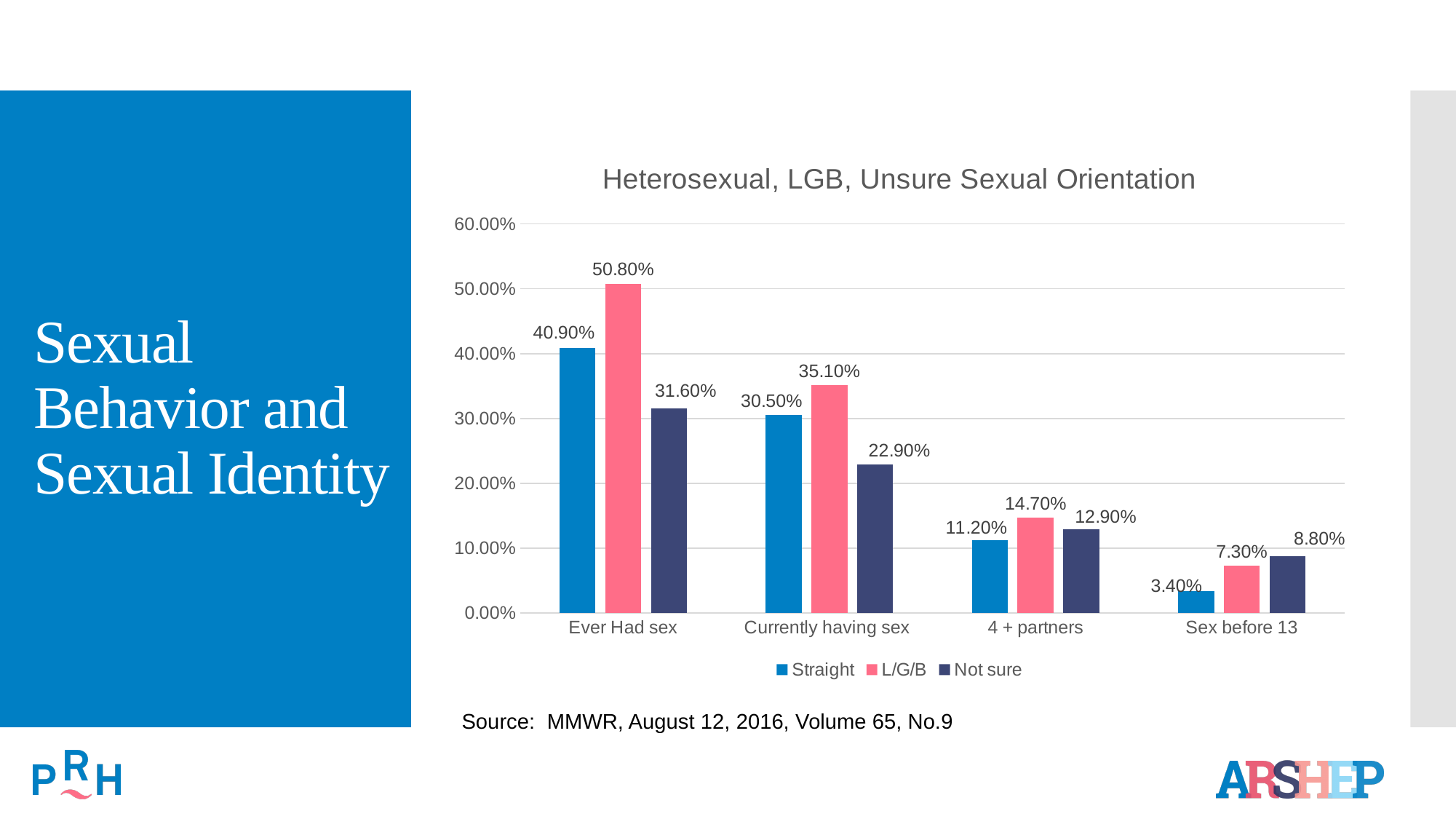
What is the value for Not sure in the Currently having sex category? 22.90% Is the value for Not sure in the Ever Had sex category greater or less than 30.00%? greater What is the value for L/G/B in the Ever Had sex category? 50.80% Which series has the highest value in the Ever Had sex category? L/G/B How many series does the legend list? 3 What is the title of the chart? Heterosexual, LGB, Unsure Sexual Orientation What kind of chart is shown on the slide? Bar chart What is the value for Straight in the Sex before 13 category? 3.40% How many categories are shown on the x axis? 4 Which is larger for 4 + partners: the Straight value or the Not sure value? Not sure Which series has the lowest value in the Sex before 13 category? Straight What is the difference between the L/G/B and Straight values for Currently having sex? 4.60%